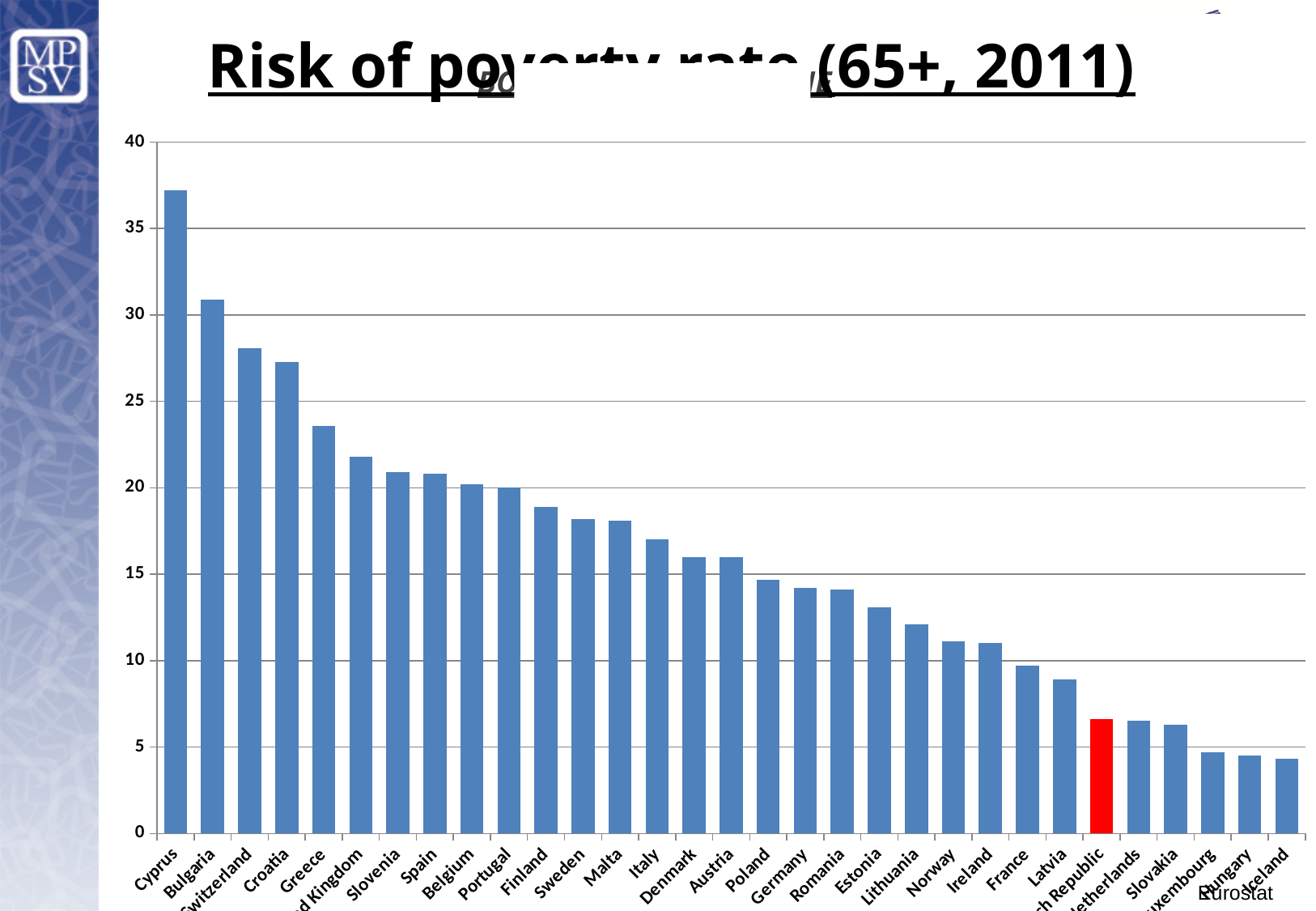
Which country has the highest risk of poverty rate in the chart? Cyprus Is the value for Finland greater or less than 20? less Do the values rise or fall moving from left to right along the x axis? Fall Is the value for Greece greater or less than 25? less Is the value for France greater or less than 10? less Which has a higher value, Italy or Poland? Italy Which has a higher value, Bulgaria or Switzerland? Bulgaria How many countries are shown in the chart? 31 What kind of chart is shown on the slide? Bar chart